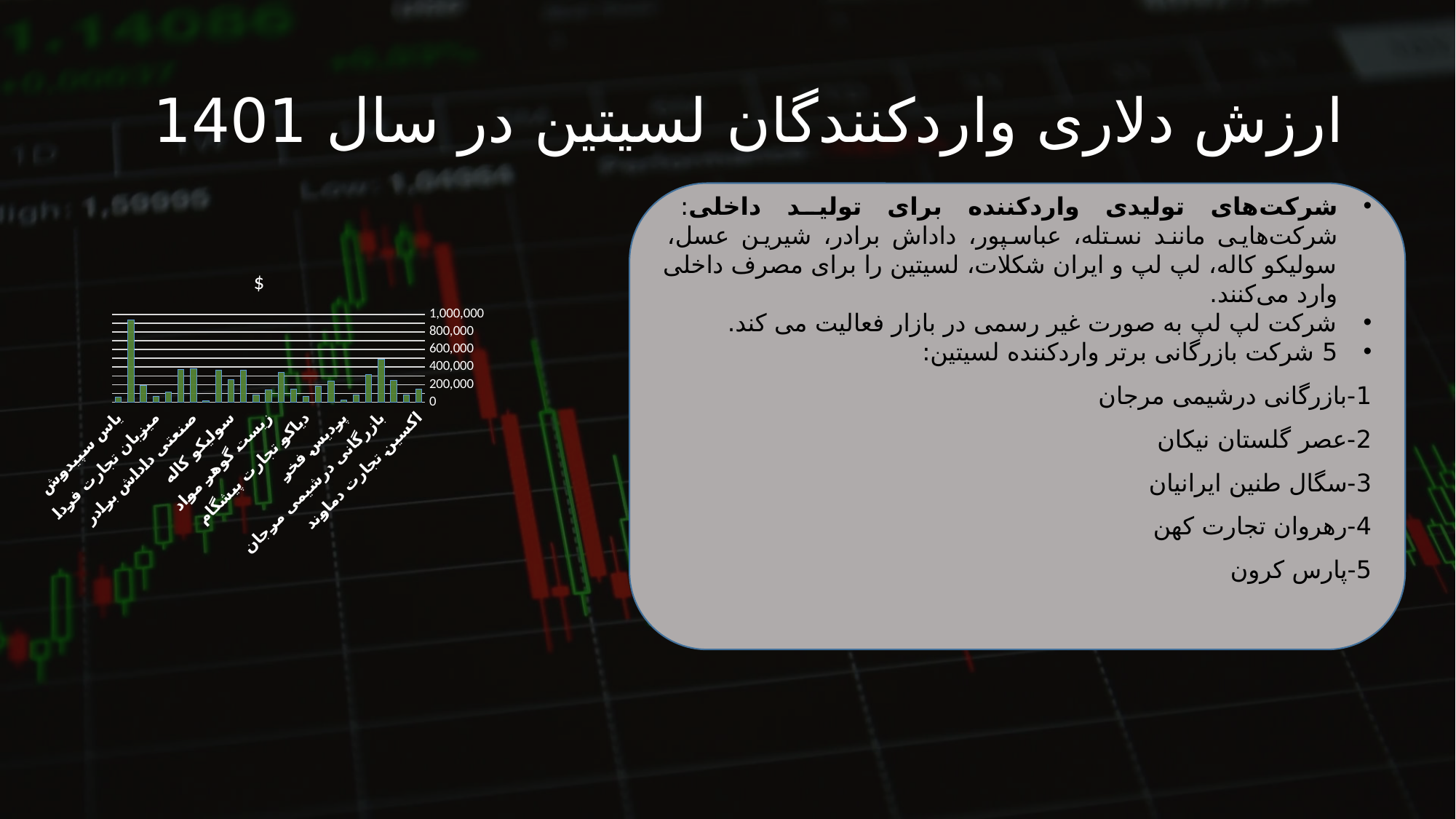
What kind of chart is shown on the left of the slide? bar chart What is the highest value shown on the vertical axis of the chart? 1,000,000 Is the tallest bar in the chart greater or less than 1,000,000? less Is the tallest bar in the chart greater or less than 800,000? greater What is the title of the chart on the left of the slide? $